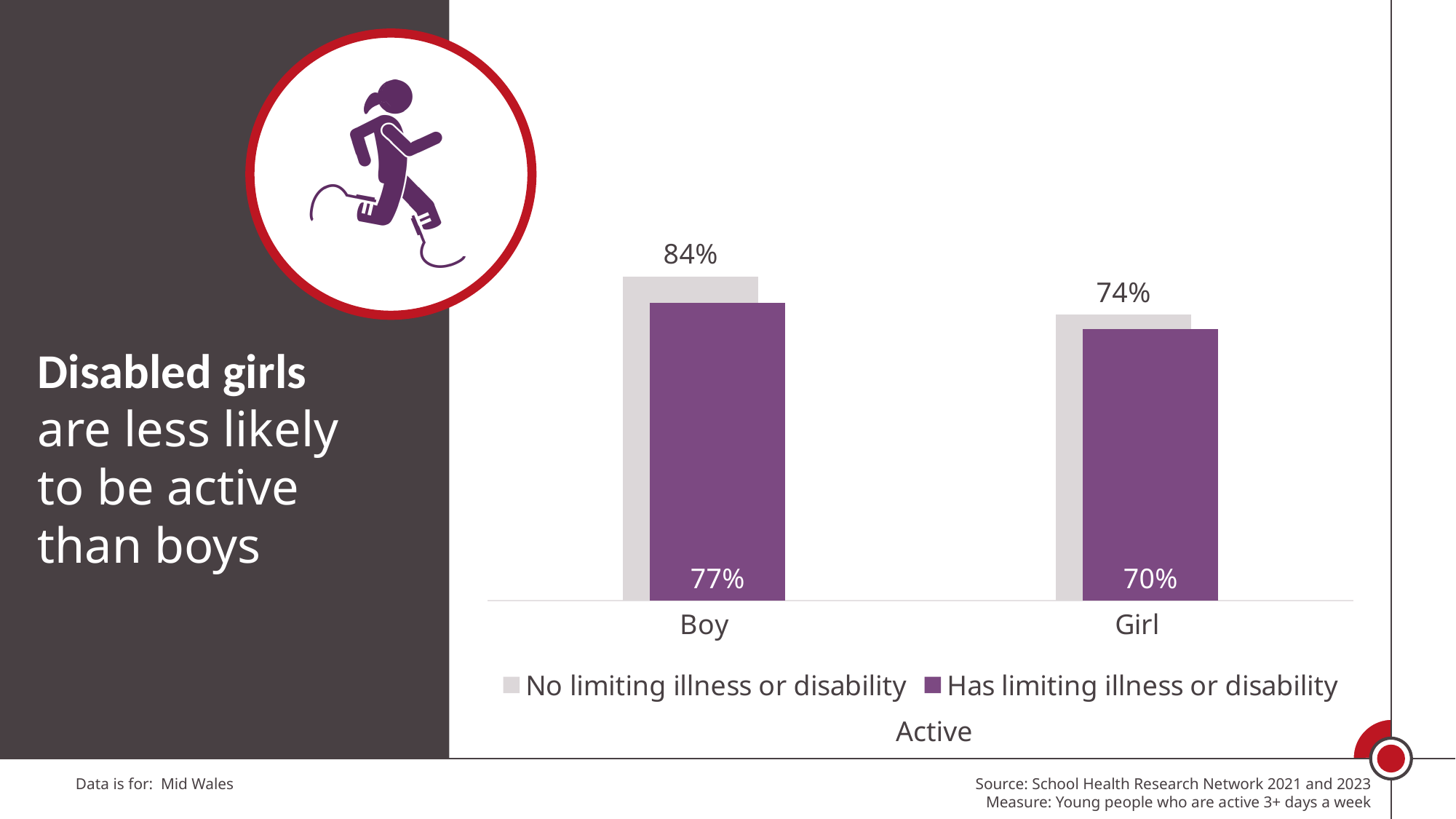
How many categories are shown on the x axis? 2 Which group has the highest value on the chart? Boy, no limiting illness or disability What is the value for girls with no limiting illness or disability? 74% How many series does the legend list? 2 What percentage of boys with no limiting illness or disability are active? 84% What is the value for boys who have a limiting illness or disability? 77% Which group has the lowest value on the chart? Girl, has limiting illness or disability What is the difference between girls with no limiting illness or disability and girls with a limiting illness or disability? 4 percentage points What kind of chart is shown on the slide? Bar chart What percentage of girls with a limiting illness or disability are active? 70% What is the difference between boys with no limiting illness or disability and boys with a limiting illness or disability? 7 percentage points Which is larger: the value for girls with no limiting illness or disability, or the value for boys with a limiting illness or disability? Boys with a limiting illness or disability